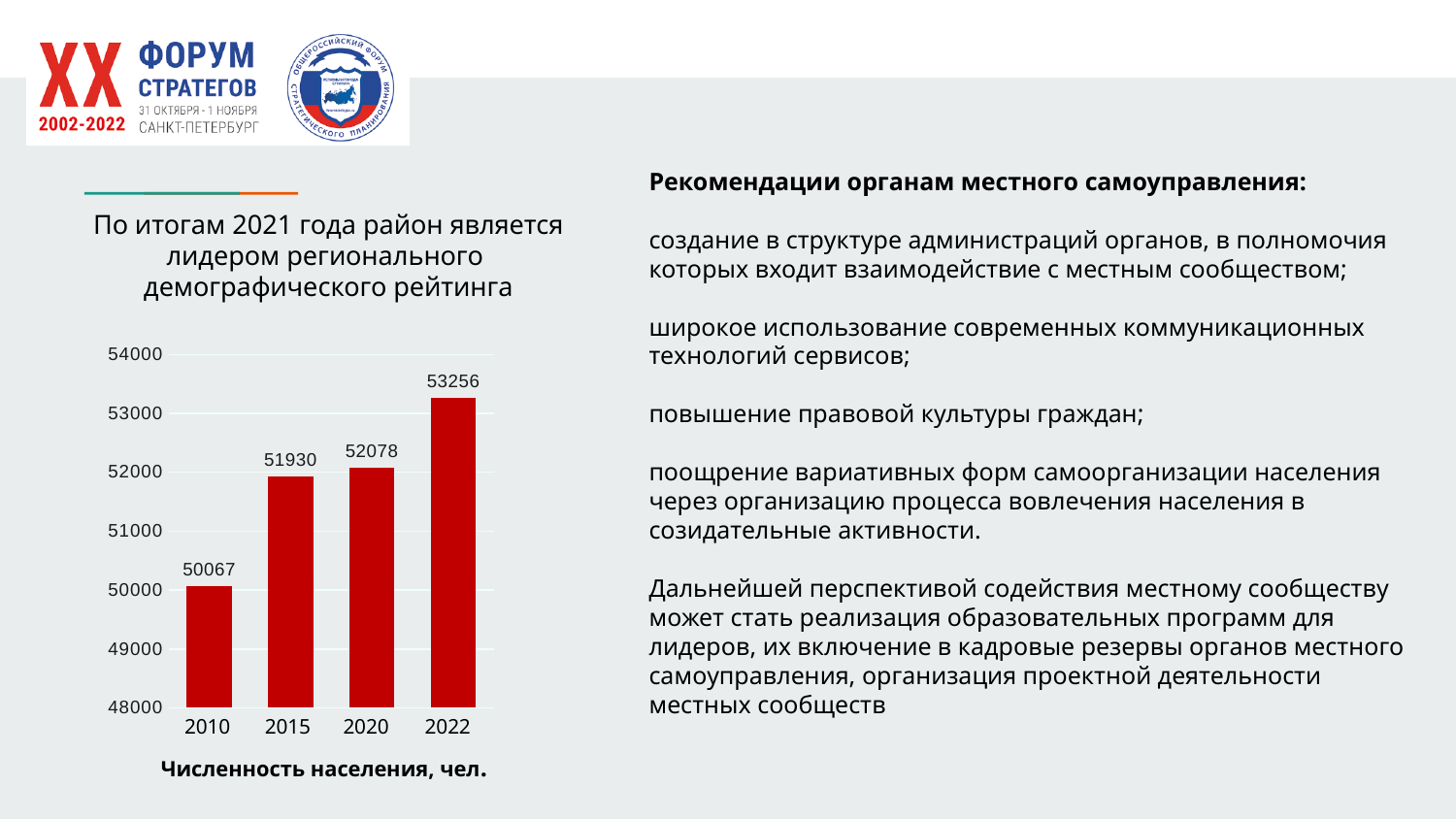
Which is larger, the population value for 2015 or for 2010? 2015 How many years are shown on the chart? 4 Which year has the highest population value? 2022 What is the difference between the population values for 2020 and 2015? 148 Do the population values rise or fall from 2010 to 2022? rise What is the difference between the population values for 2022 and 2010? 3189 What kind of chart is shown on the slide? bar chart What is the population value shown for 2015? 51930 What is the population value shown for 2022? 53256 What is the population value shown for 2010? 50067 What is the population value shown for 2020? 52078 Which year has the lowest population value? 2010